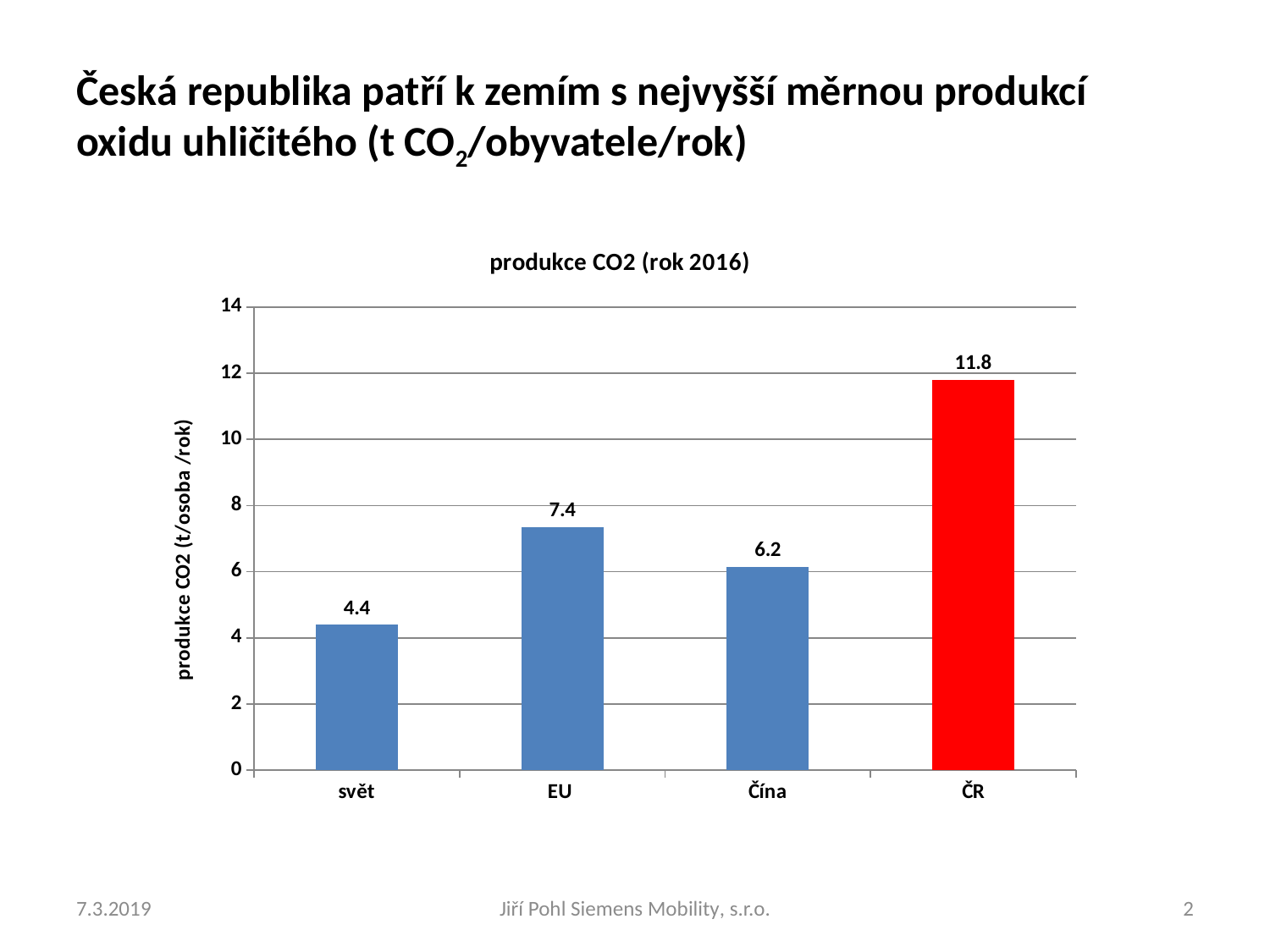
What is the value for svět? 4.4 Which category has the highest value? ČR What is the value for ČR? 11.8 What is the title of the chart? produkce CO2 (rok 2016) How many categories are shown on the x axis? 4 What kind of chart is shown on the slide? bar chart Is the value for Čína greater or less than 8? less What is the value for Čína? 6.2 Which category has the lowest value? svět What is the value for EU? 7.4 What is the difference between the values for ČR and EU? 4.4 Which is larger, the value for EU or the value for Čína? EU